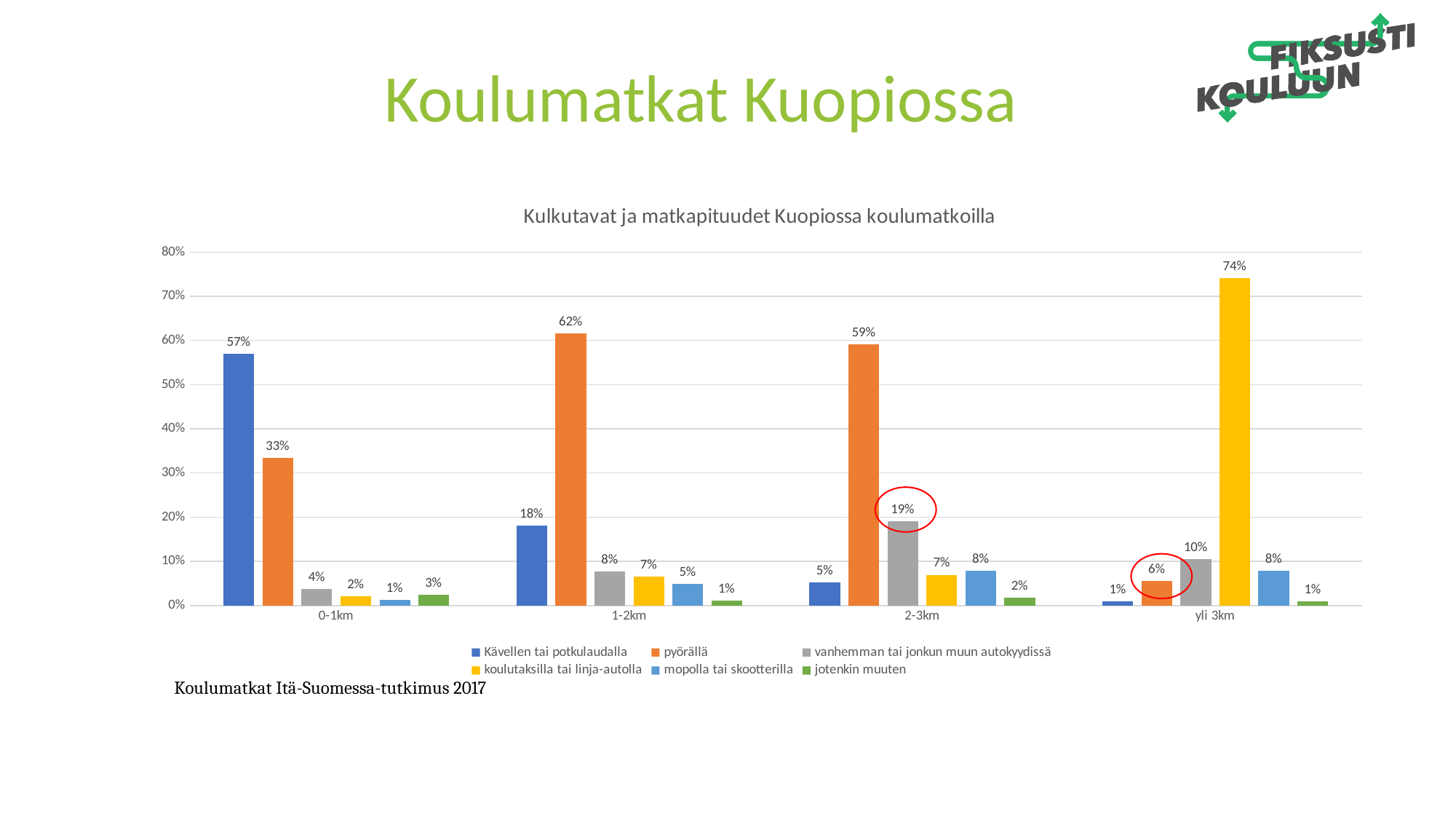
What is the value for 'Kävellen tai potkulaudalla' in the 0-1km category? 57% Which is larger: 'Kävellen tai potkulaudalla' at 0-1km or 'pyörällä' at 0-1km? Kävellen tai potkulaudalla Which series has the highest value in the 1-2km category? pyörällä What is the value for 'vanhemman tai jonkun muun autokyydissä' in the 2-3km category? 19% How many series does the legend list? 6 What kind of chart is shown on the slide? bar chart What is the title of the chart? Kulkutavat ja matkapituudet Kuopiossa koulumatkoilla What is the difference between the 'pyörällä' values for 1-2km and 2-3km? 3% How many distance categories are shown on the x axis? 4 Does the value for 'Kävellen tai potkulaudalla' rise or fall as the distance categories increase from 0-1km to yli 3km? fall What is the value for 'koulutaksilla tai linja-autolla' in the 'yli 3km' category? 74%